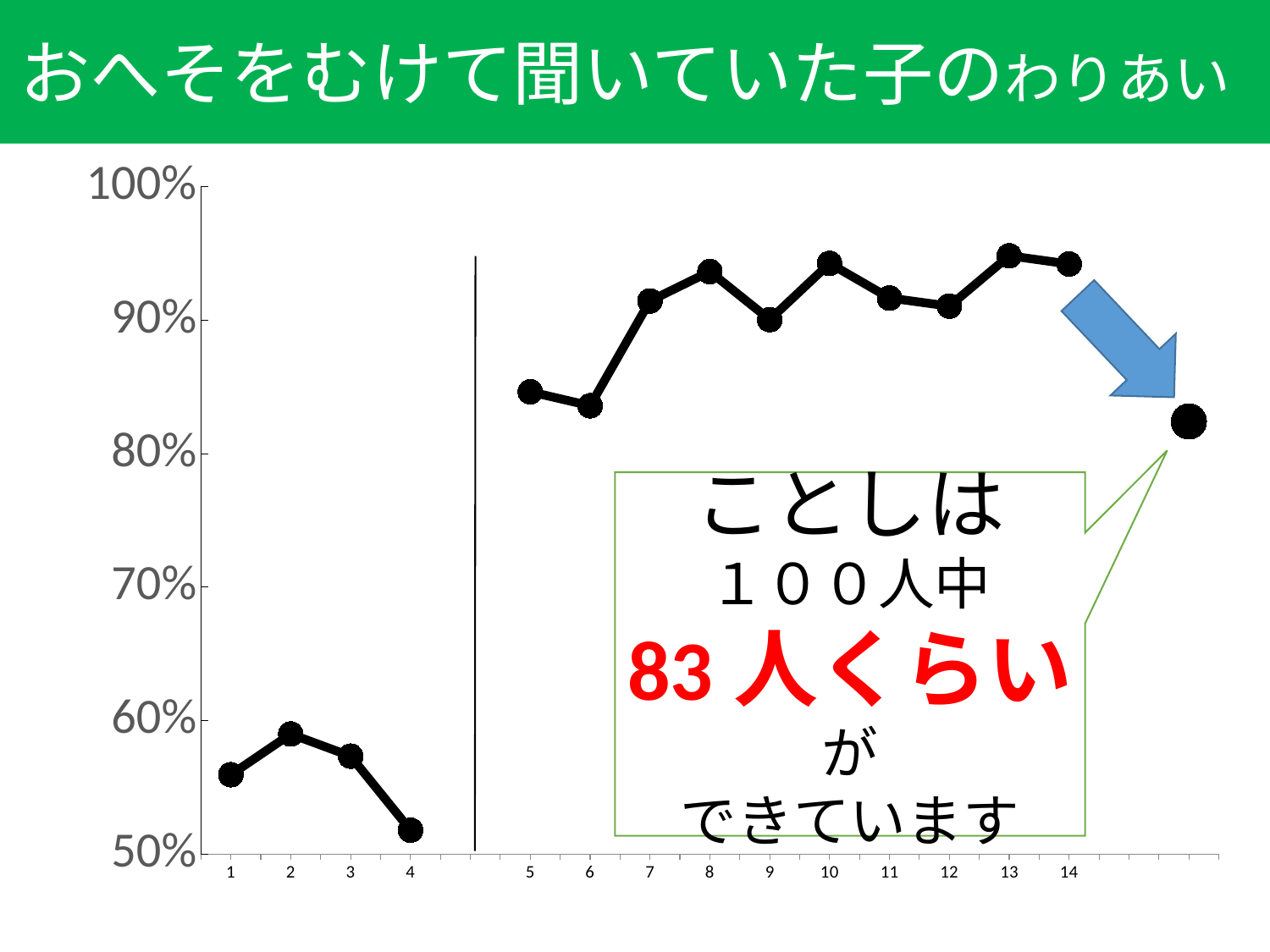
Which has the larger value, category 2 or category 14? 14 What is the highest tick value shown on the y axis? 100% Is the value for category 8 greater or less than 90%? greater Which has the larger value, category 4 or category 5? 5 Is the value for category 5 greater or less than 90%? less What kind of chart is shown on the slide? line chart Is the value of the final point (marked by the blue arrow) greater or less than 90%? less Do the values rise or fall from category 2 to category 4? fall How many numbered categories are labelled on the x axis? 14 Which numbered category on the x axis has the lowest value? 4